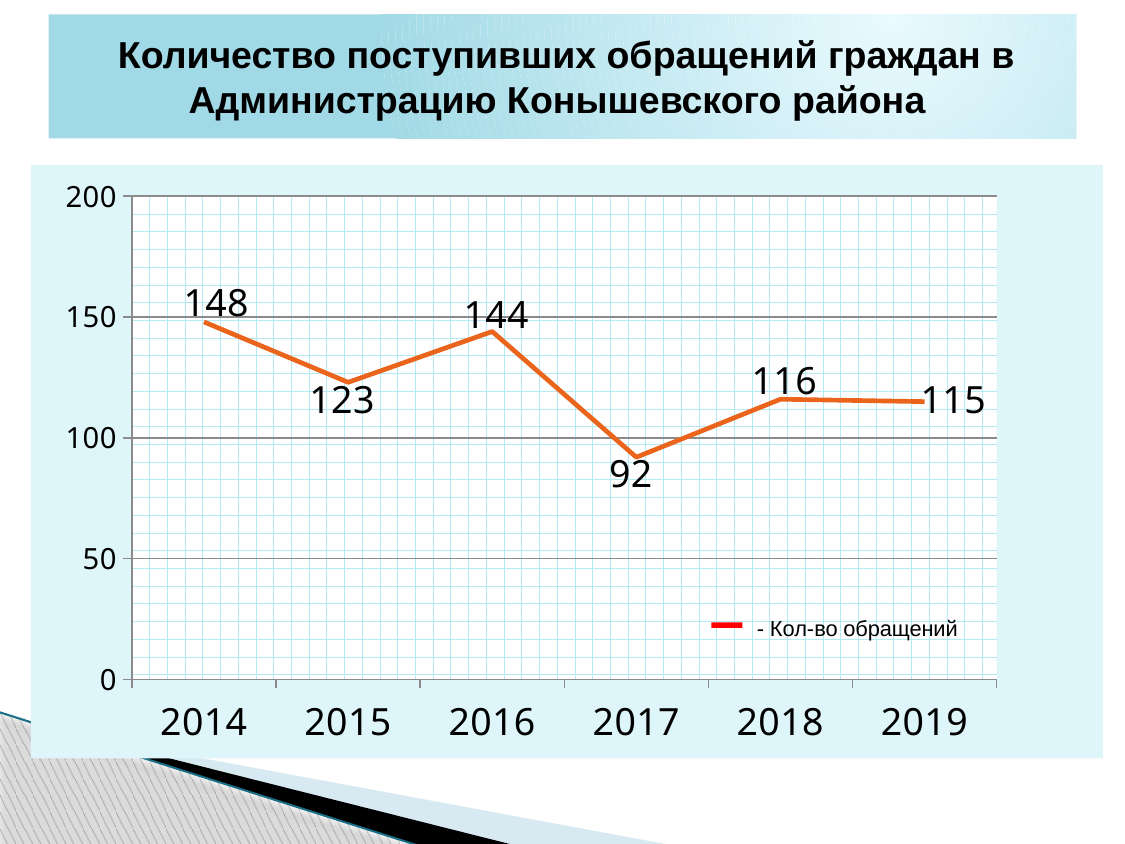
Do the values rise or fall from 2016 to 2017? fall What is the number of appeals in 2017? 92 What is the number of appeals in 2019? 115 Which year has the highest number of appeals? 2014 Which year has the lowest number of appeals? 2017 How many years are shown on the x axis? 6 What is the number of appeals in 2014? 148 What is the difference between the number of appeals in 2016 and in 2017? 52 Is the value for 2017 greater or less than 100? less What kind of chart is shown on the slide? line chart Which year has more appeals, 2015 or 2016? 2016 What is the legend entry for the plotted line? Кол-во обращений